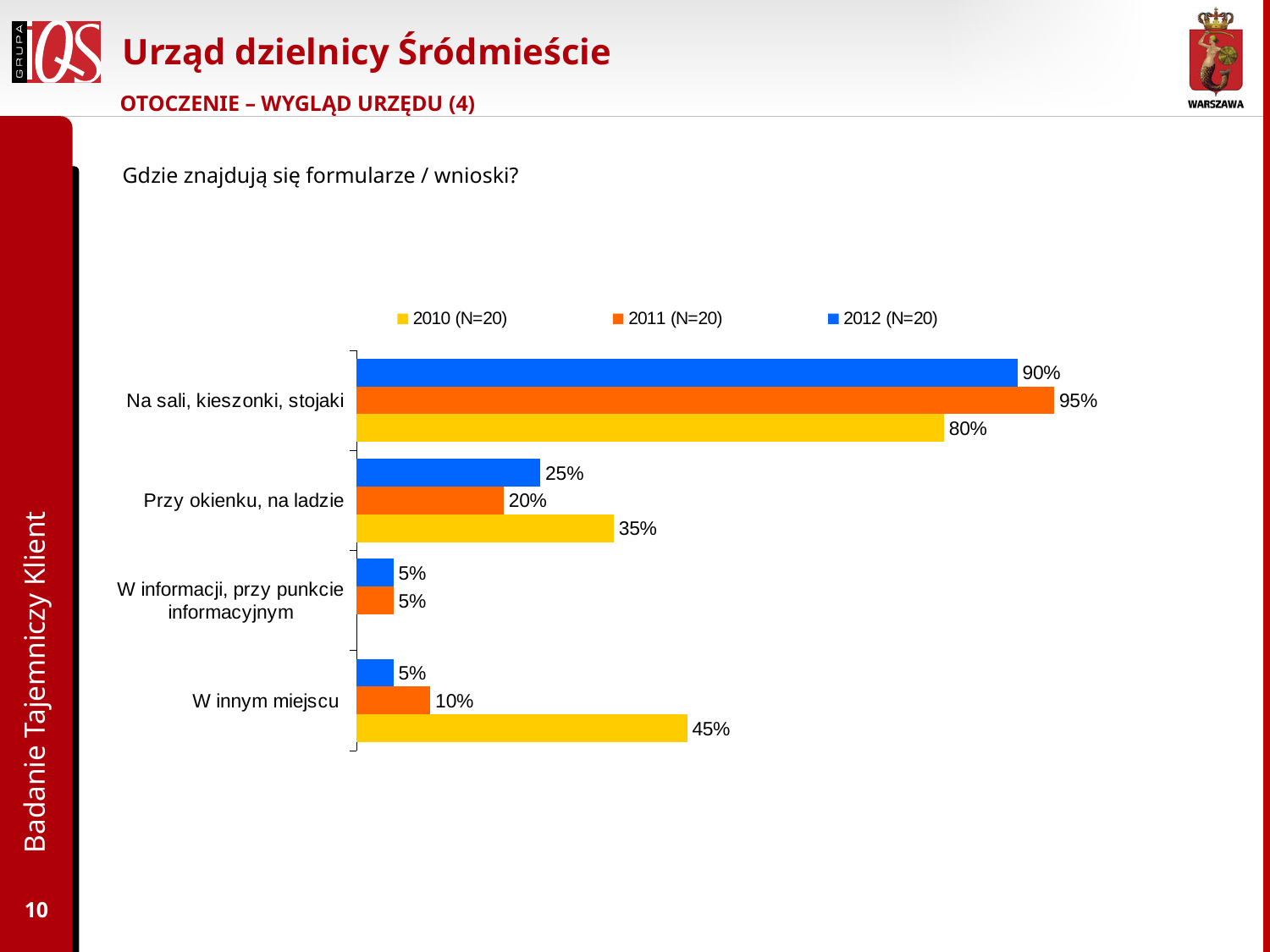
Which is larger for "Przy okienku, na ladzie": the 2012 (N=20) value or the 2011 (N=20) value? 2012 (N=20) What kind of chart is shown on the slide? Bar chart What is the value for "W innym miejscu" in the 2011 (N=20) series? 10% What is the difference between the 2010 (N=20) and 2012 (N=20) values for "W innym miejscu"? 40% Which category has the highest value in the 2011 (N=20) series? Na sali, kieszonki, stojaki How many series does the legend list? 3 How many categories are shown on the chart? 4 What question is the chart answering, according to the text above it? Gdzie znajdują się formularze / wnioski? What is the value for "Na sali, kieszonki, stojaki" in the 2012 (N=20) series? 90% What is the value for "Przy okienku, na ladzie" in the 2010 (N=20) series? 35% What is the difference between the 2011 (N=20) and 2010 (N=20) values for "Na sali, kieszonki, stojaki"? 15%